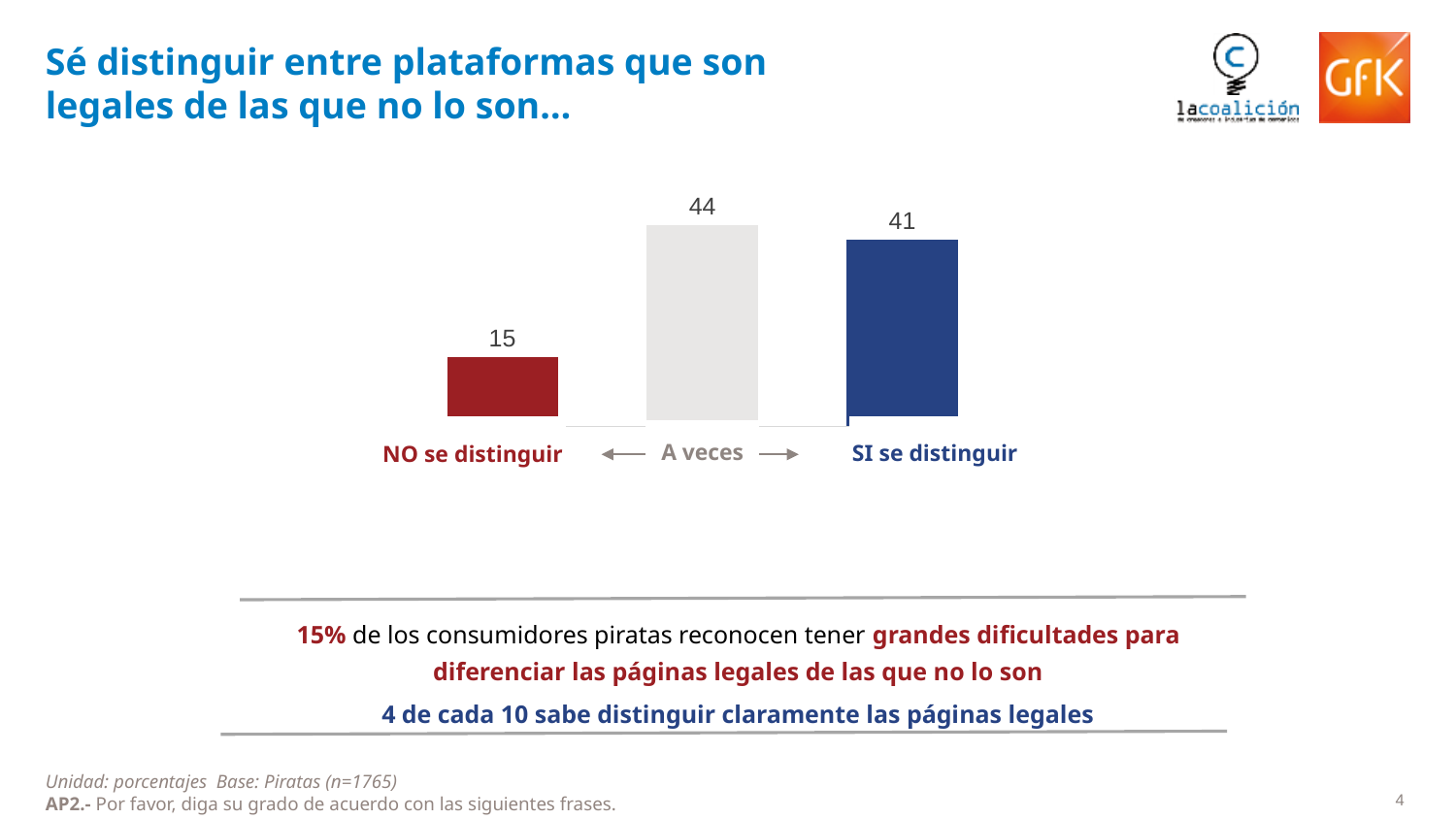
How many categories are shown in the chart? 3 What is the value for 'A veces'? 44 Which category has the lowest value? NO se distinguir What colour is the bar for 'SI se distinguir'? Blue Which category has the highest value? A veces What is the difference between the values for 'A veces' and 'SI se distinguir'? 3 What is the value for 'NO se distinguir'? 15 What is the value for 'SI se distinguir'? 41 What is the difference between the values for 'SI se distinguir' and 'NO se distinguir'? 26 Which is larger, the value for 'NO se distinguir' or the value for 'SI se distinguir'? SI se distinguir What is the total of the three values shown in the chart? 100 What kind of chart is shown on the slide? Bar chart